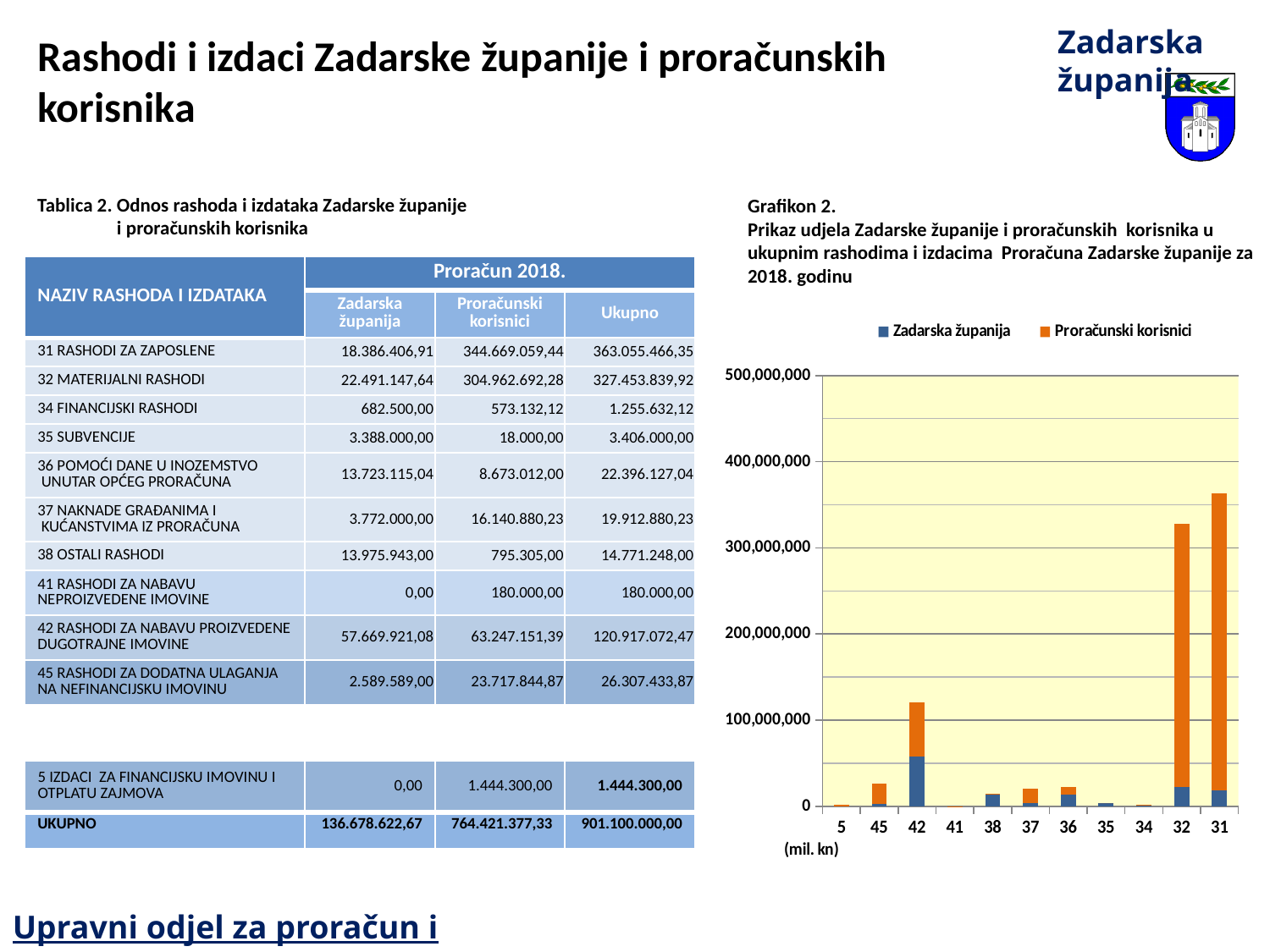
In Grafikon 2, which series is shown in orange? Proračunski korisnici What kind of chart is Grafikon 2? bar chart In Grafikon 2, which category has the highest total bar? 31 What unit label is shown below the x axis of Grafikon 2? (mil. kn) In Grafikon 2, which total bar is larger, category 42 or category 45? 42 In Grafikon 2, is the total bar for category 42 greater or less than 100,000,000? greater In Grafikon 2, is the total bar for category 31 greater or less than 300,000,000? greater In Grafikon 2, which total bar is larger, category 32 or category 42? 32 How many categories are shown on the x axis of Grafikon 2? 11 How many series does the legend of Grafikon 2 list? 2 In Grafikon 2, is the total bar for category 31 greater or less than 400,000,000? less